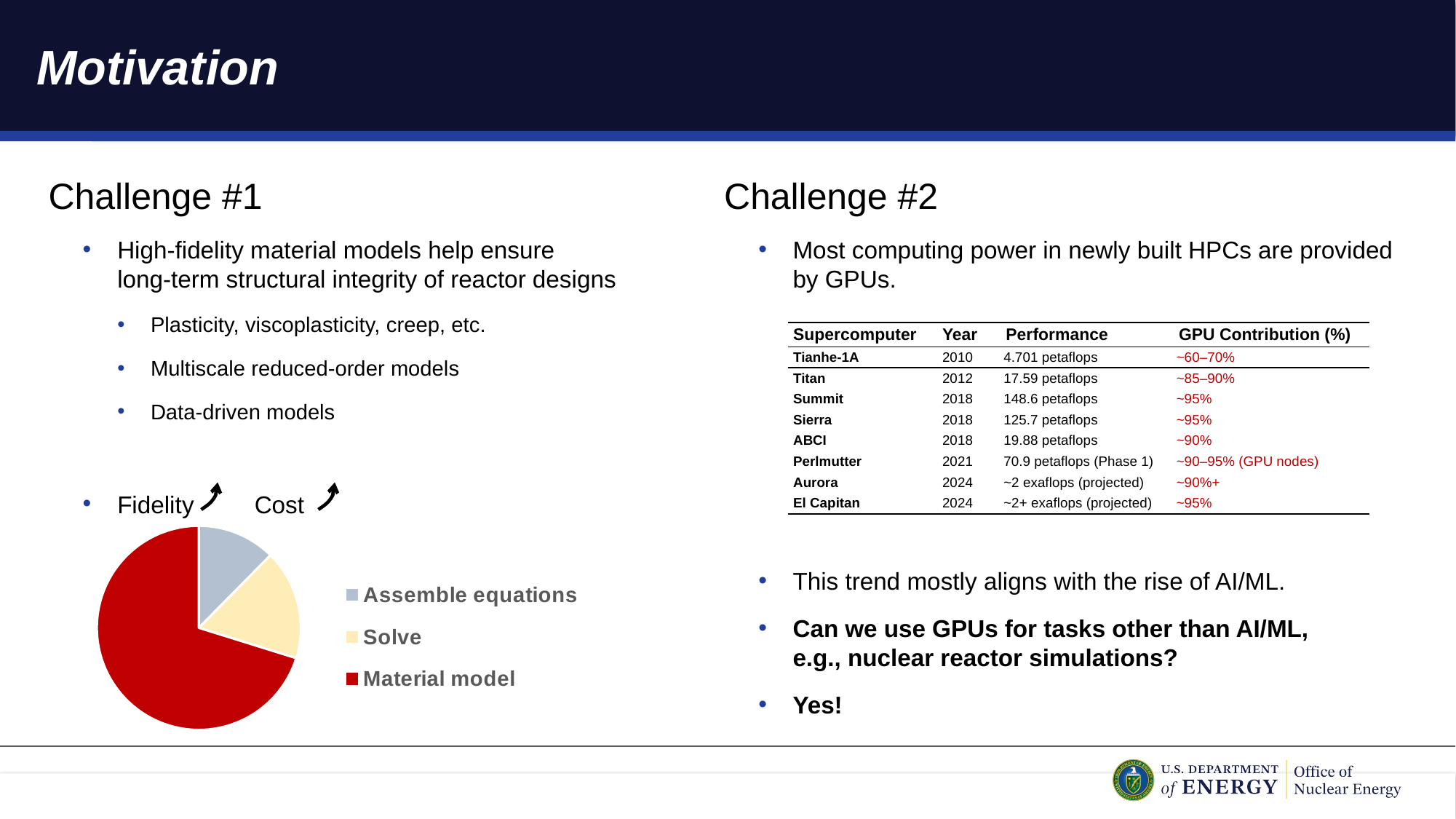
Which legend entry in the pie chart is shown in yellow? Solve Which category takes up the smallest slice of the pie chart? Assemble equations In the pie chart, which slice is larger: Material model or Solve? Material model How many slices does the pie chart have? 3 What colour is the Material model slice in the pie chart? red How many entries does the pie chart's legend list? 3 Which category takes up the largest slice of the pie chart? Material model In the pie chart, which slice is larger: Solve or Assemble equations? Solve What kind of chart is shown on the slide? pie chart